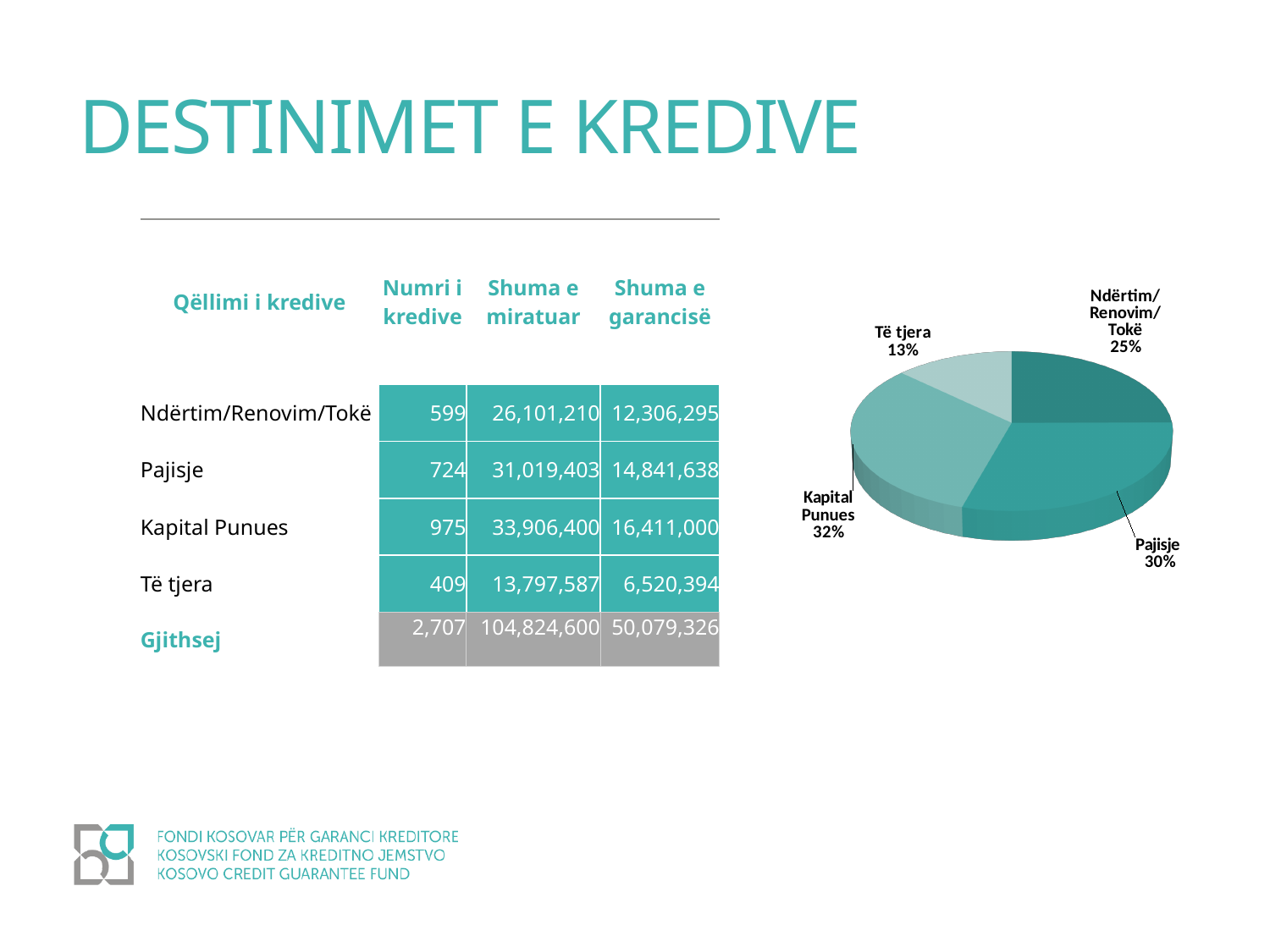
What kind of chart is shown on the slide? Pie chart What share of the pie does Ndërtim/Renovim/Tokë represent? 25% What is the title of the slide containing the pie chart? DESTINIMET E KREDIVE What share of the pie does Të tjera represent? 13% Which is larger in the pie chart, Pajisje or Ndërtim/Renovim/Tokë? Pajisje What share of the pie does Kapital Punues represent? 32% What is the difference in percentage points between the Kapital Punues slice and the Të tjera slice? 19 How many slices does the pie chart have? 4 What is the difference in percentage points between the Pajisje slice and the Ndërtim/Renovim/Tokë slice? 5 Which slice of the pie chart is the largest? Kapital Punues Which slice of the pie chart is the smallest? Të tjera